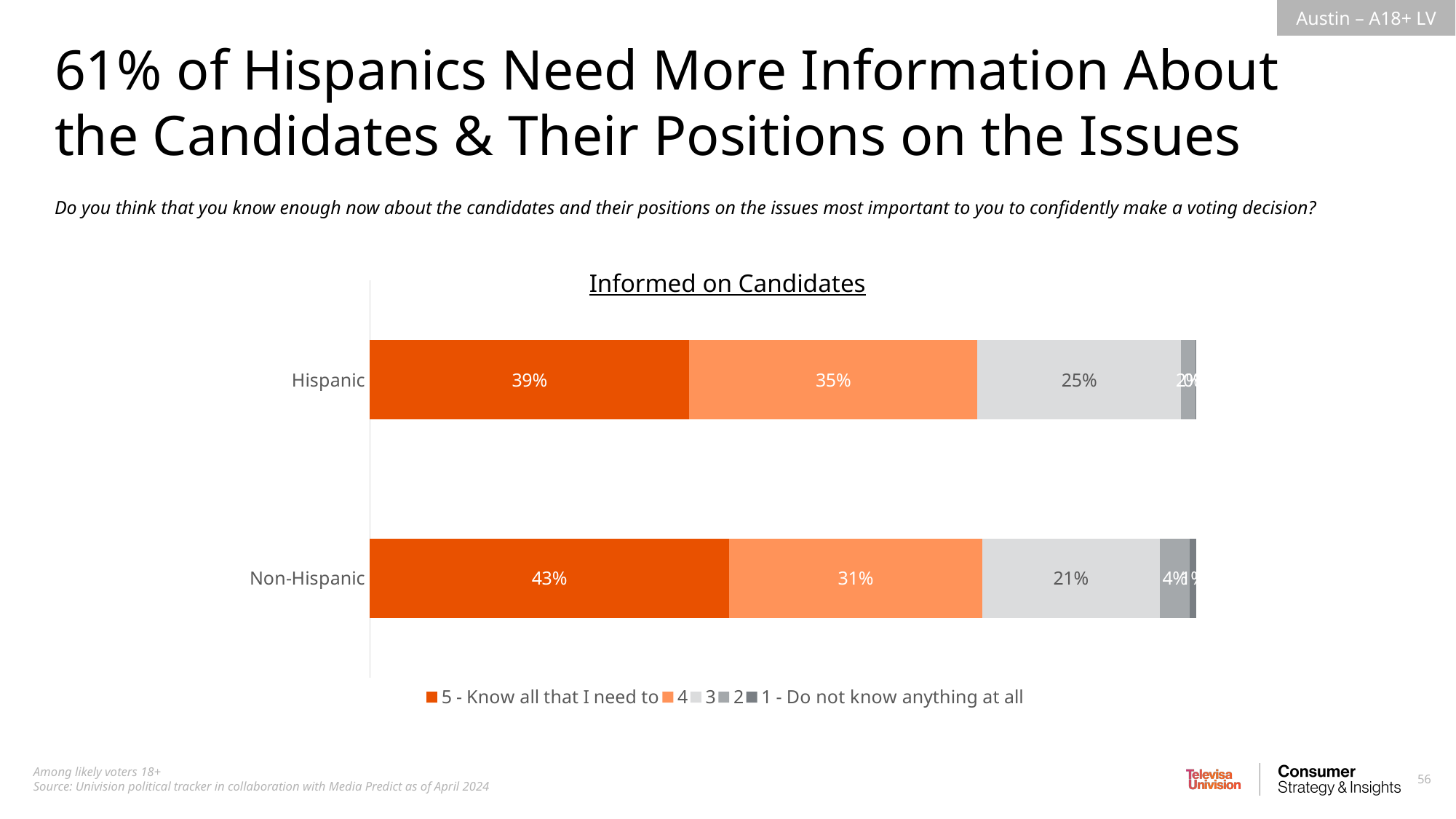
How many groups (categories) are shown on the chart? 2 What is the difference in percentage points between the Non-Hispanic and Hispanic shares answering "5 - Know all that I need to"? 4 percentage points What percentage of Hispanic respondents answered "5 - Know all that I need to"? 39% What percentage of Non-Hispanic respondents gave a rating of 3? 21% How many series does the legend list? 5 What type of chart is shown on the slide? Stacked bar chart Which group has the larger share giving a rating of 4, Hispanic or Non-Hispanic? Hispanic What percentage of Hispanic respondents gave a rating of 4? 35% What is the difference in percentage points between the Hispanic and Non-Hispanic shares giving a rating of 3? 4 percentage points What percentage of Non-Hispanic respondents answered "5 - Know all that I need to"? 43% Which group has the larger share answering "5 - Know all that I need to", Hispanic or Non-Hispanic? Non-Hispanic What percentage of Hispanic respondents gave a rating of 3? 25%